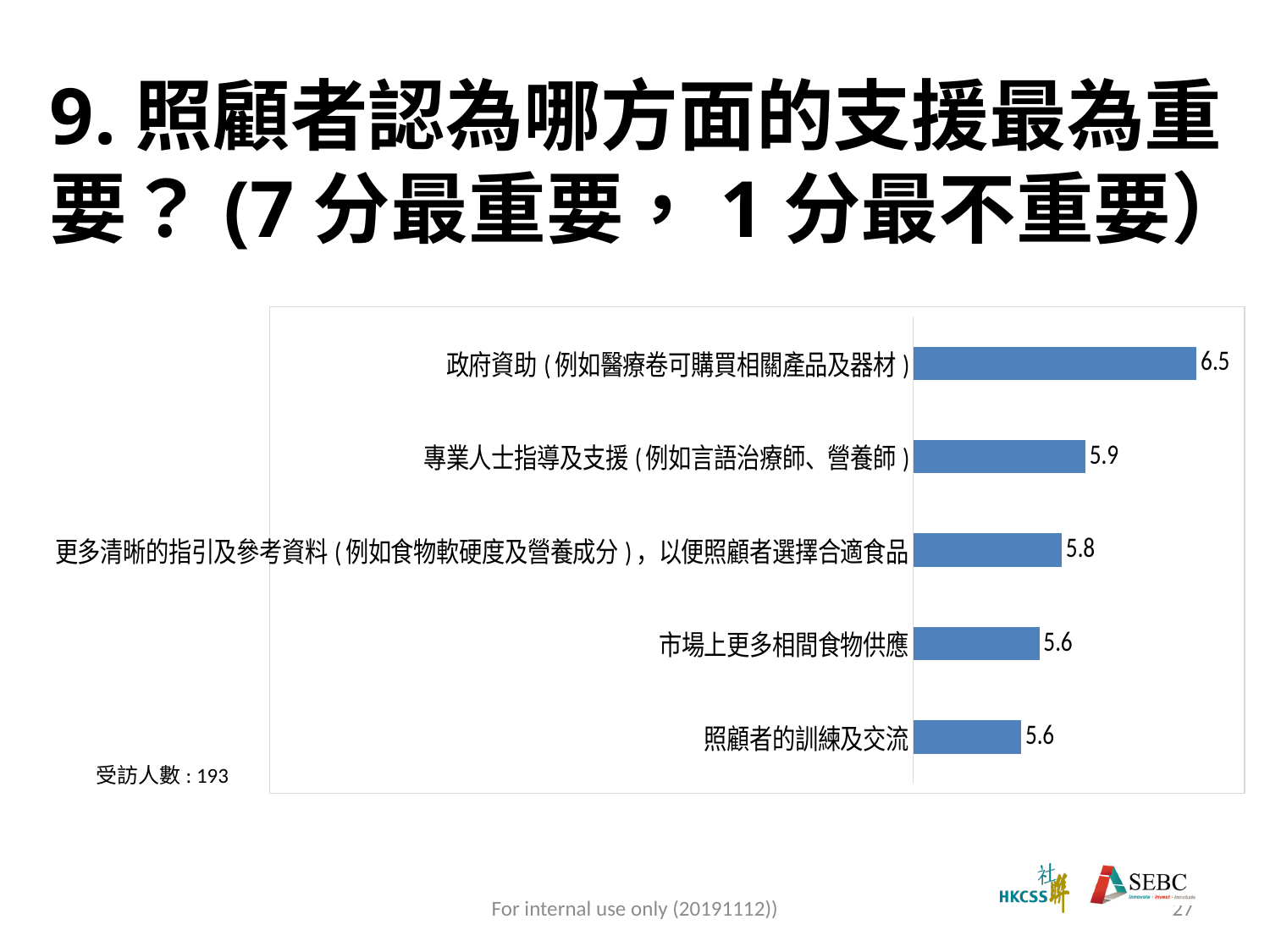
What colour are the bars in the chart? Blue Which is larger, the value for 政府資助 or the value for 市場上更多相間食物供應? 政府資助 Which category has the highest value? 政府資助 (例如醫療卷可購買相關產品及器材) How many respondents does the slide state (受訪人數)? 193 How many categories are shown in the chart? 5 What is the difference between the values for 專業人士指導及支援 and 更多清晰的指引及參考資料? 0.1 What is the difference between the values for 政府資助 and 專業人士指導及支援? 0.6 What kind of chart is shown on the slide? Bar chart What is the value for 政府資助 (例如醫療卷可購買相關產品及器材)? 6.5 What is the value for 市場上更多相間食物供應? 5.6 What is the value for 專業人士指導及支援 (例如言語治療師、營養師)? 5.9 What is the value for 照顧者的訓練及交流? 5.6